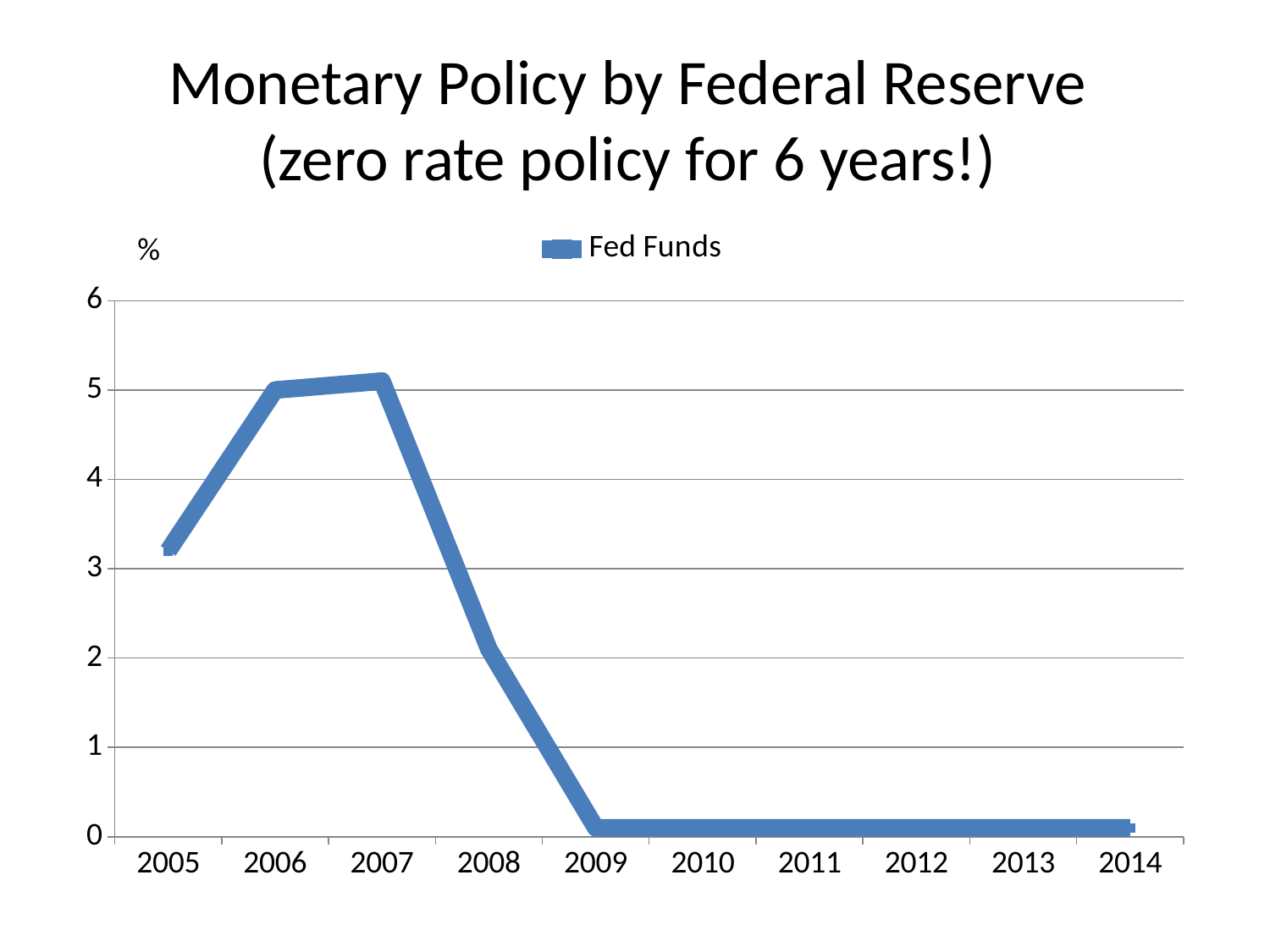
Which year has the larger Fed Funds value, 2005 or 2007? 2007 How many series does the legend list? 1 Does the Fed Funds rate rise or fall from 2007 to 2009? fall Is the Fed Funds value for 2014 greater or less than 1? less How many years are plotted along the x axis? 10 Is the Fed Funds value for 2009 greater or less than 1? less Which year has the larger Fed Funds value, 2006 or 2008? 2006 Is the Fed Funds value for 2006 greater or less than 4? greater What is the name of the series shown in the legend? Fed Funds What kind of chart is shown on the slide? line chart